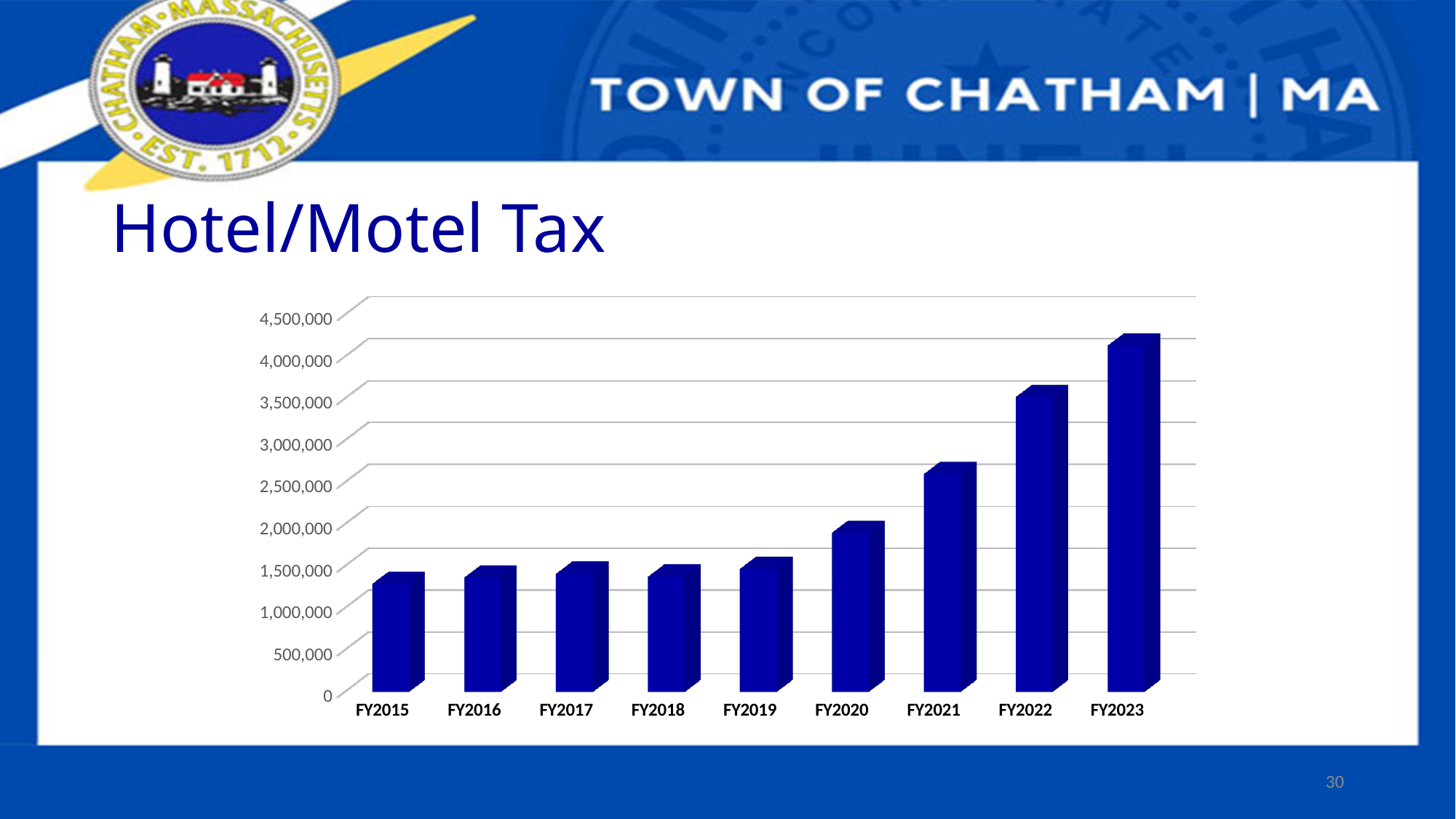
Is the value for FY2021 greater or less than 2,000,000? greater Which fiscal year has the lowest Hotel/Motel Tax value? FY2015 Is the value for FY2015 greater or less than 1,000,000? greater How many fiscal years are plotted on the chart? 9 Which is larger, the value for FY2022 or the value for FY2021? FY2022 Is the value for FY2022 greater or less than 3,000,000? greater Do the Hotel/Motel Tax values generally rise or fall from FY2015 to FY2023? Rise What is the title of the slide containing the chart? Hotel/Motel Tax Which fiscal year has the highest Hotel/Motel Tax value? FY2023 What kind of chart is shown on the slide? Bar chart